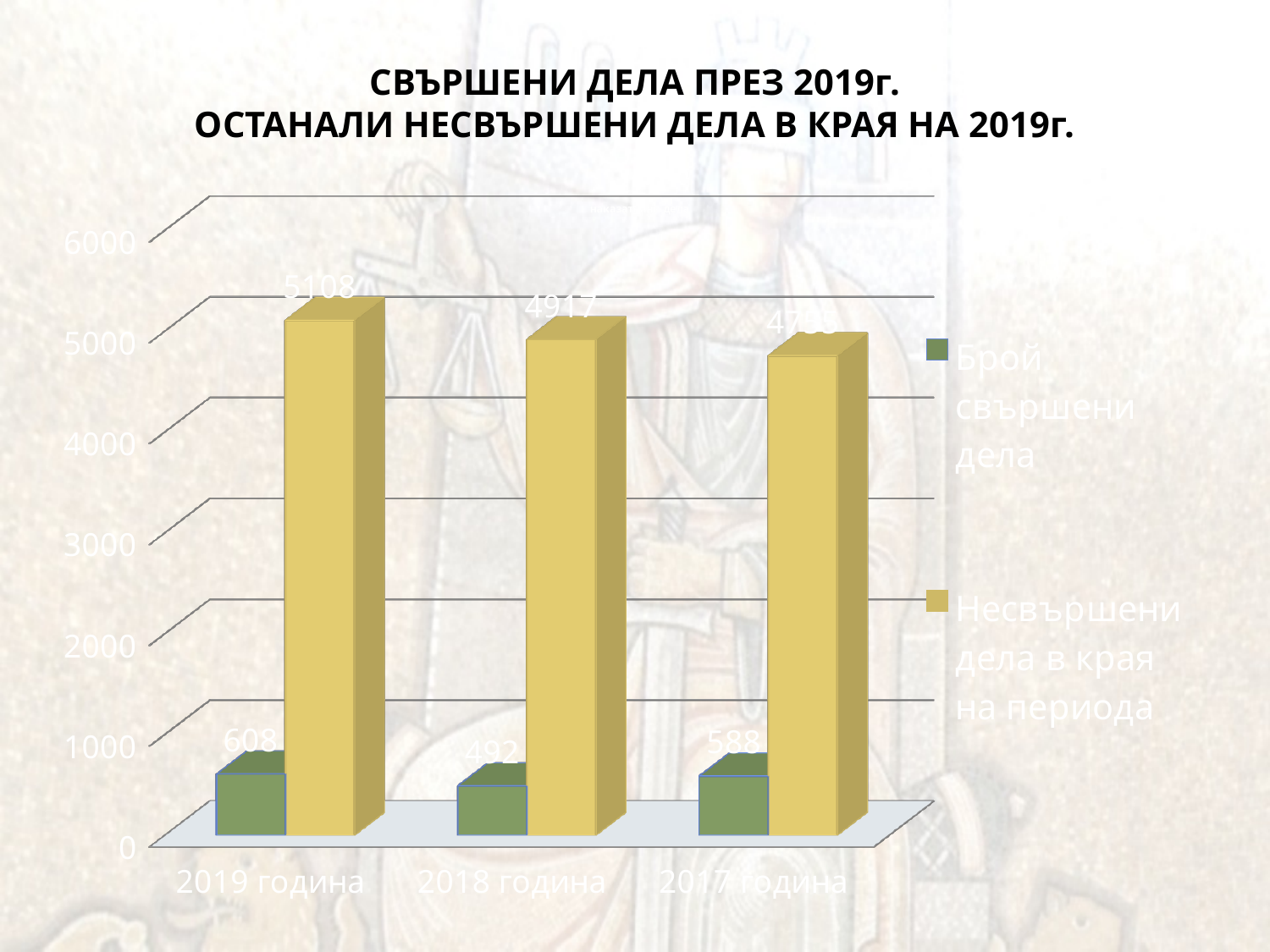
What is the value of Брой свършени дела for 2017 година? 588 Which year has the lowest value for Брой свършени дела? 2018 година What is the value of Несвършени дела в края на периода for 2019 година? 5108 Is the value of Несвършени дела в края на периода for 2017 година greater or less than 4000? greater What is the difference between the Брой свършени дела values for 2019 година and 2018 година? 116 What is the value of Брой свършени дела for 2019 година? 608 How many series does the legend list? 2 Which year has the highest value for Несвършени дела в края на периода? 2019 година What kind of chart is shown on the slide? bar chart What is the value of Брой свършени дела for 2018 година? 492 What is the value of Несвършени дела в края на периода for 2018 година? 4917 What is the difference between the Несвършени дела в края на периода values for 2019 година and 2018 година? 191